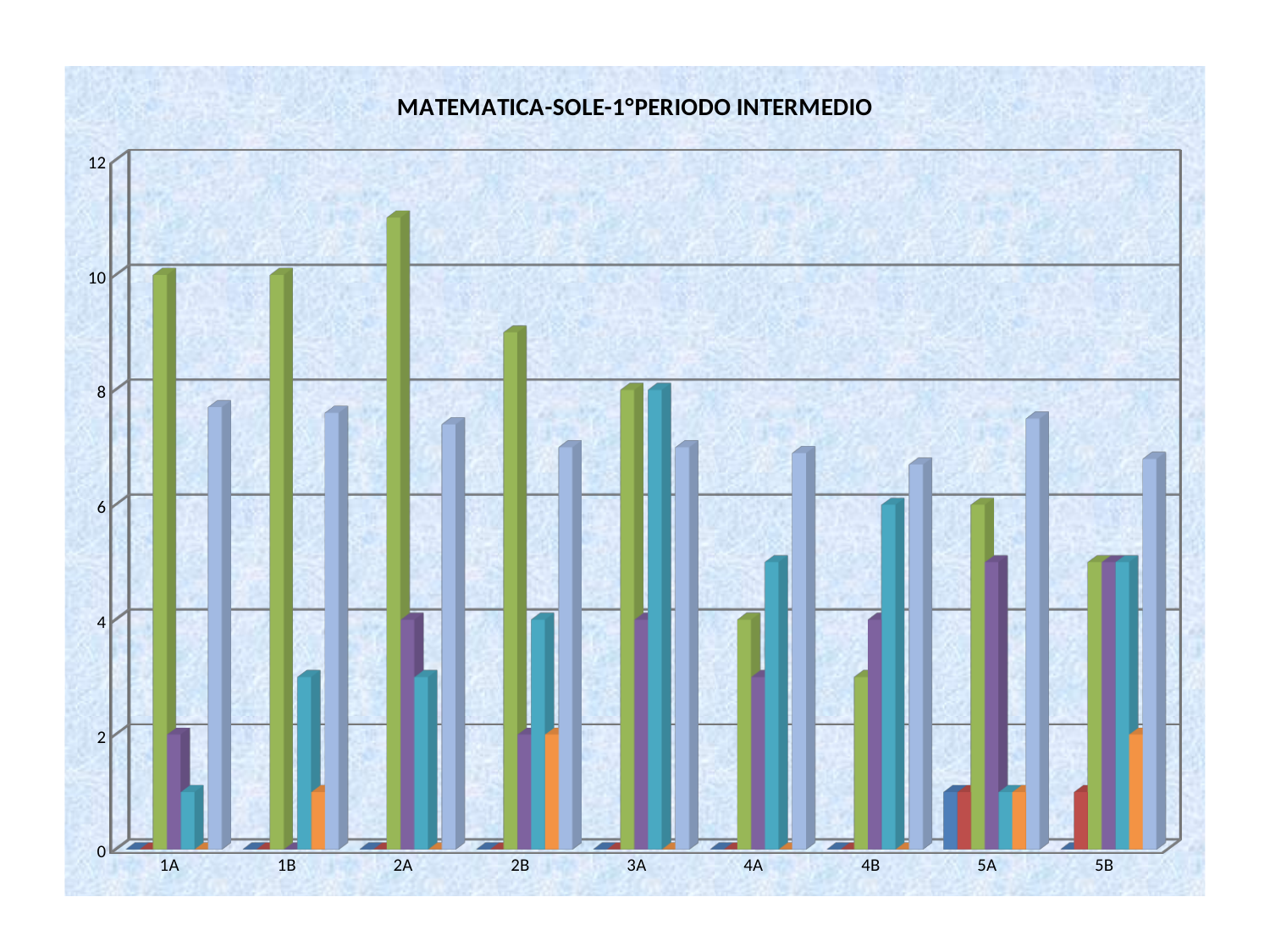
What is the highest value shown on the vertical axis? 12 Is the green bar for 2A greater or less than 10? greater Is the orange bar for 2B greater or less than 4? less Is the green bar for 4B greater or less than 4? less What is the title of the chart? MATEMATICA-SOLE-1°PERIODO INTERMEDIO Which category has the tallest green bar? 2A Which category has the tallest teal bar? 3A What kind of chart is shown on the slide? bar chart Which is larger, the green bar for 1A or the green bar for 4A? 1A Which category has the shortest green bar? 4B How many categories are shown on the x axis of the chart? 9